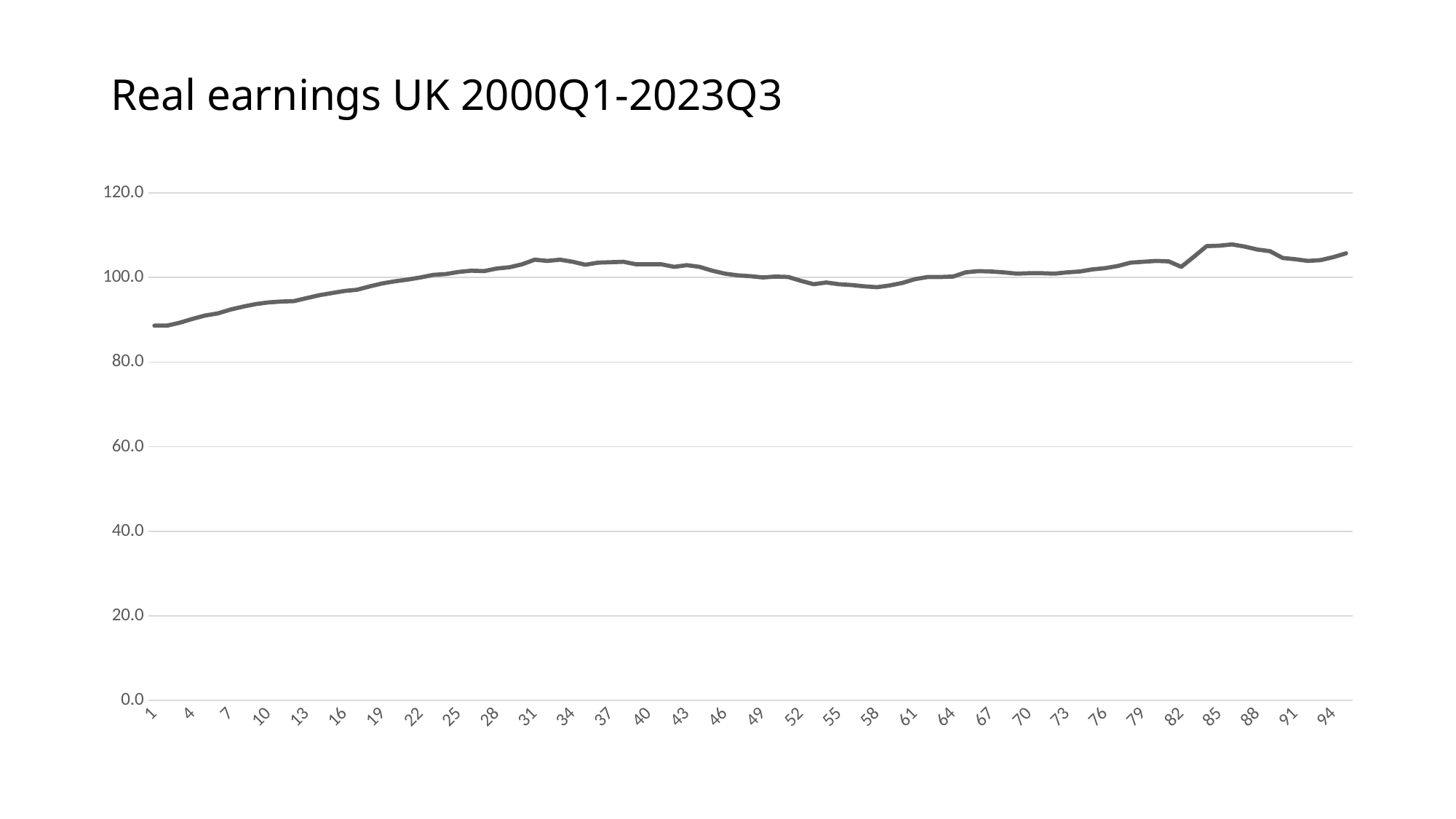
Is the value at x = 1 greater or less than 80? greater Which has the larger value, x = 31 or x = 58? 31 Overall, do the values rise or fall from the left of the x axis to the right? rise Is the value at x = 85 greater or less than 100? greater Is the value at x = 1 greater or less than 100? less What is the title of the chart? Real earnings UK 2000Q1-2023Q3 What is the highest value labelled on the y axis? 120.0 Which has the larger value, x = 1 or x = 85? 85 What kind of chart is shown on the slide? line chart